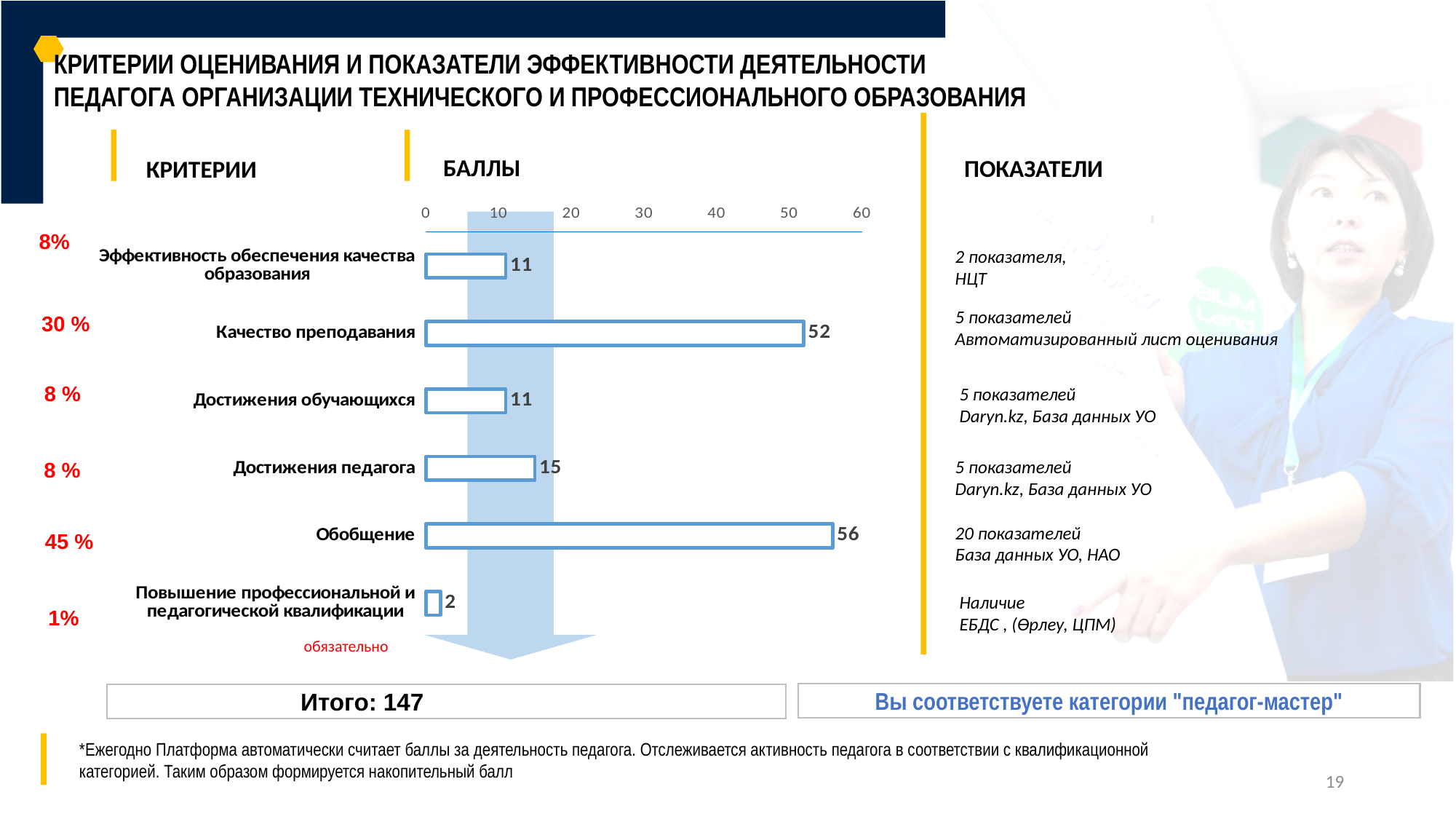
Is the value for Качество преподавания greater or less than 50? greater What is the difference between the values for Обобщение and Качество преподавания? 4 Which category has the lowest value? Повышение профессиональной и педагогической квалификации What is the highest tick value shown on the chart's axis? 60 How many categories are plotted in the chart? 6 Which category has the highest value? Обобщение What value is shown for Повышение профессиональной и педагогической квалификации? 2 Which is larger, the value for Достижения педагога or the value for Достижения обучающихся? Достижения педагога What value is shown for Достижения педагога? 15 What kind of chart is shown on the slide? bar chart What value is shown for Обобщение? 56 What value is shown for Качество преподавания? 52